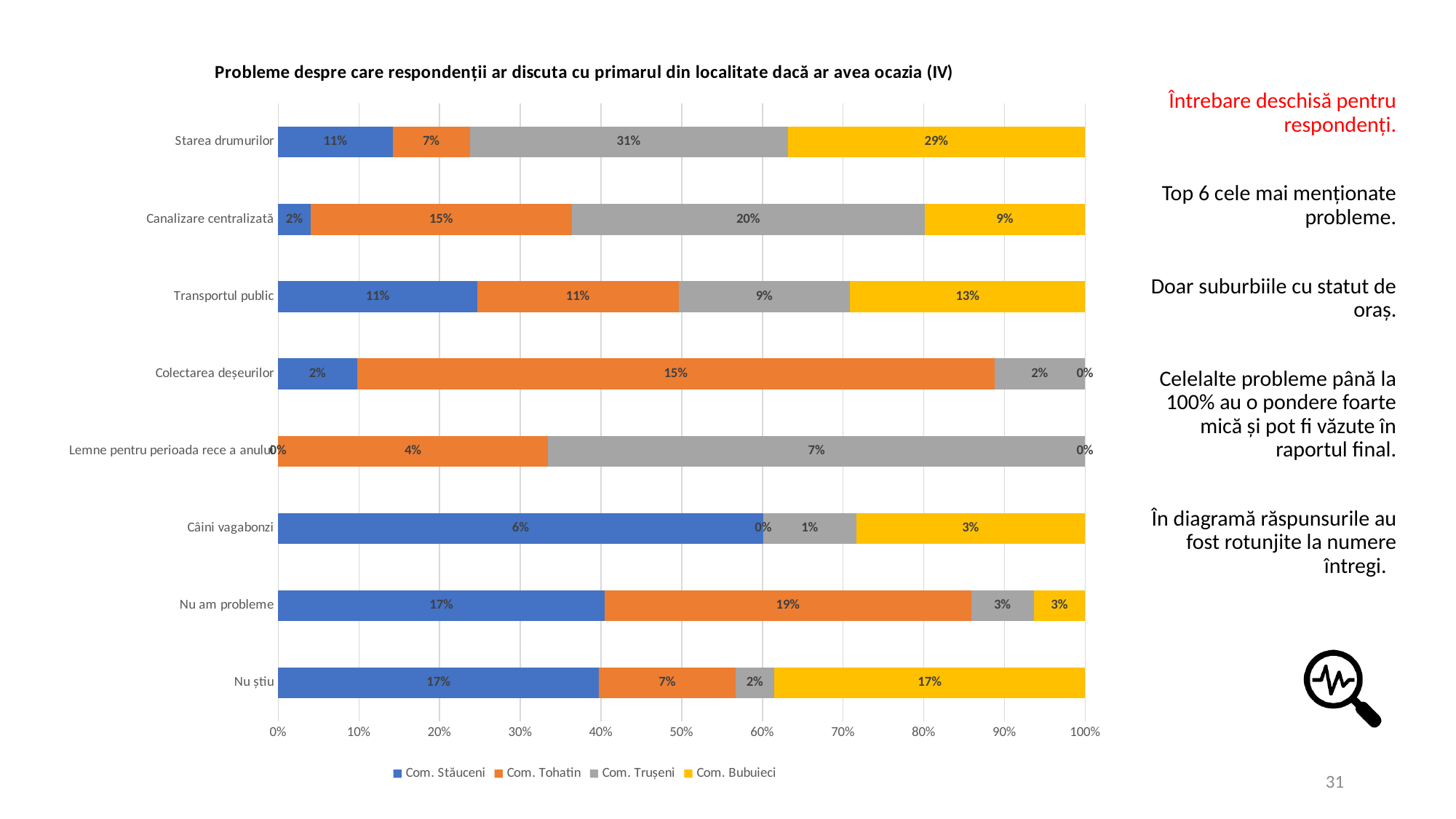
Which commune has the highest labelled value in the 'Starea drumurilor' bar? Com. Trușeni What value is labelled for Com. Bubuieci in the 'Transportul public' bar? 13% Which commune has the lowest labelled value in the 'Canalizare centralizată' bar? Com. Stăuceni What percentage is shown for Com. Trușeni in the 'Starea drumurilor' bar? 31% Which commune is represented by the yellow segments in the chart? Com. Bubuieci What value is labelled for Com. Stăuceni in the 'Câini vagabonzi' bar? 6% How many series does the chart legend list? 4 How many problem categories are listed on the vertical axis of the chart? 8 What type of chart is shown on the slide? Stacked bar chart In the 'Nu am probleme' bar, which is larger: the value for Com. Stăuceni or for Com. Tohatin? Com. Tohatin What percentage is shown for Com. Tohatin in the 'Nu am probleme' bar? 19% In the 'Starea drumurilor' bar, what is the difference between the Com. Trușeni value and the Com. Bubuieci value? 2 percentage points